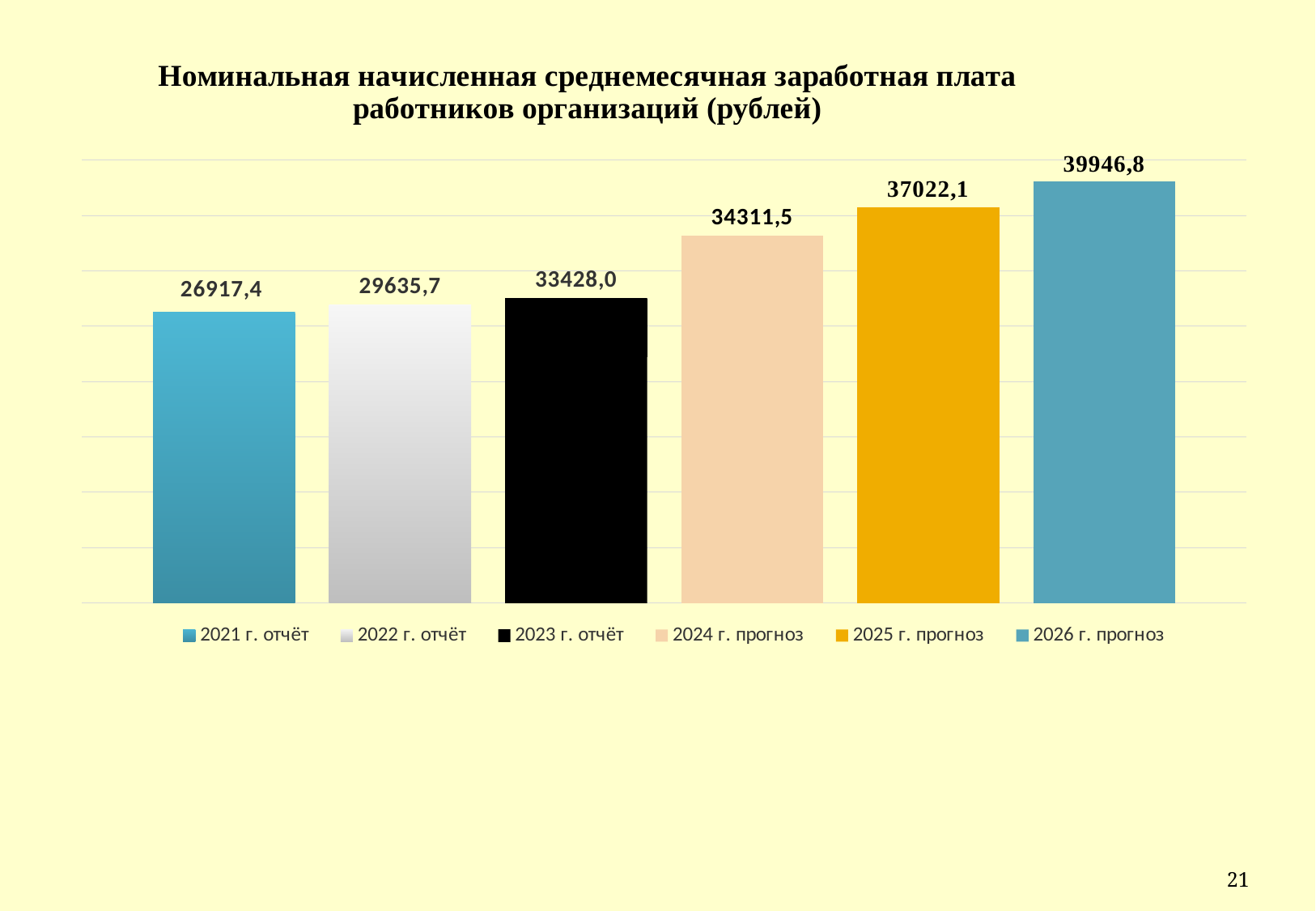
What is the value shown for 2021 г. отчёт? 26917,4 Do the values rise or fall from 2021 to 2026? Rise What kind of chart is shown on the slide? Bar chart What is the difference between the values for 2025 г. прогноз and 2024 г. прогноз? 2710,6 How many bars are shown on the chart? 6 Which year has the lowest value on the chart? 2021 г. отчёт Which is larger, the value for 2023 г. отчёт or the value for 2022 г. отчёт? 2023 г. отчёт What is the difference between the values for 2026 г. прогноз and 2021 г. отчёт? 13029,4 What is the value shown for 2024 г. прогноз? 34311,5 How many entries does the legend list? 6 What is the value shown for 2026 г. прогноз? 39946,8 Which year has the highest value on the chart? 2026 г. прогноз